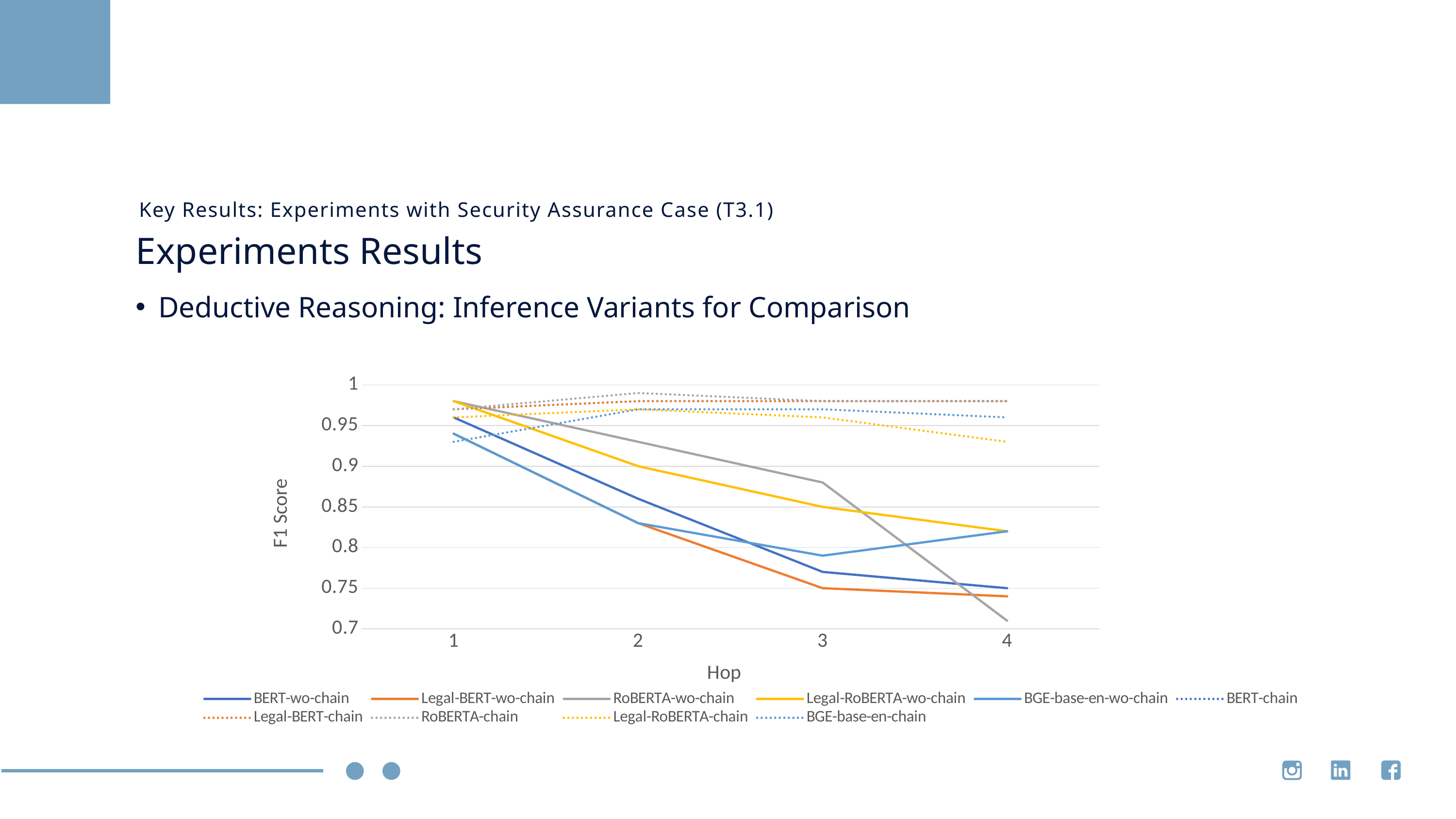
What kind of chart is shown on the slide? line chart Is the value for RoBERTA-wo-chain at hop 4 greater or less than 0.75? less How many hop values are plotted along the x axis? 4 What is the label of the y axis? F1 Score Is the value for Legal-RoBERTA-wo-chain at hop 3 greater or less than 0.8? greater Does the BERT-wo-chain series rise or fall from hop 1 to hop 4? fall Is the value for Legal-RoBERTA-chain at hop 4 greater or less than 0.95? less At hop 4, which is higher: BGE-base-en-wo-chain or BERT-wo-chain? BGE-base-en-wo-chain What is the label of the x axis? Hop How many series does the legend list? 10 Which series has the lowest F1 Score at hop 4? RoBERTA-wo-chain Does the BGE-base-en-wo-chain series rise or fall from hop 3 to hop 4? rise